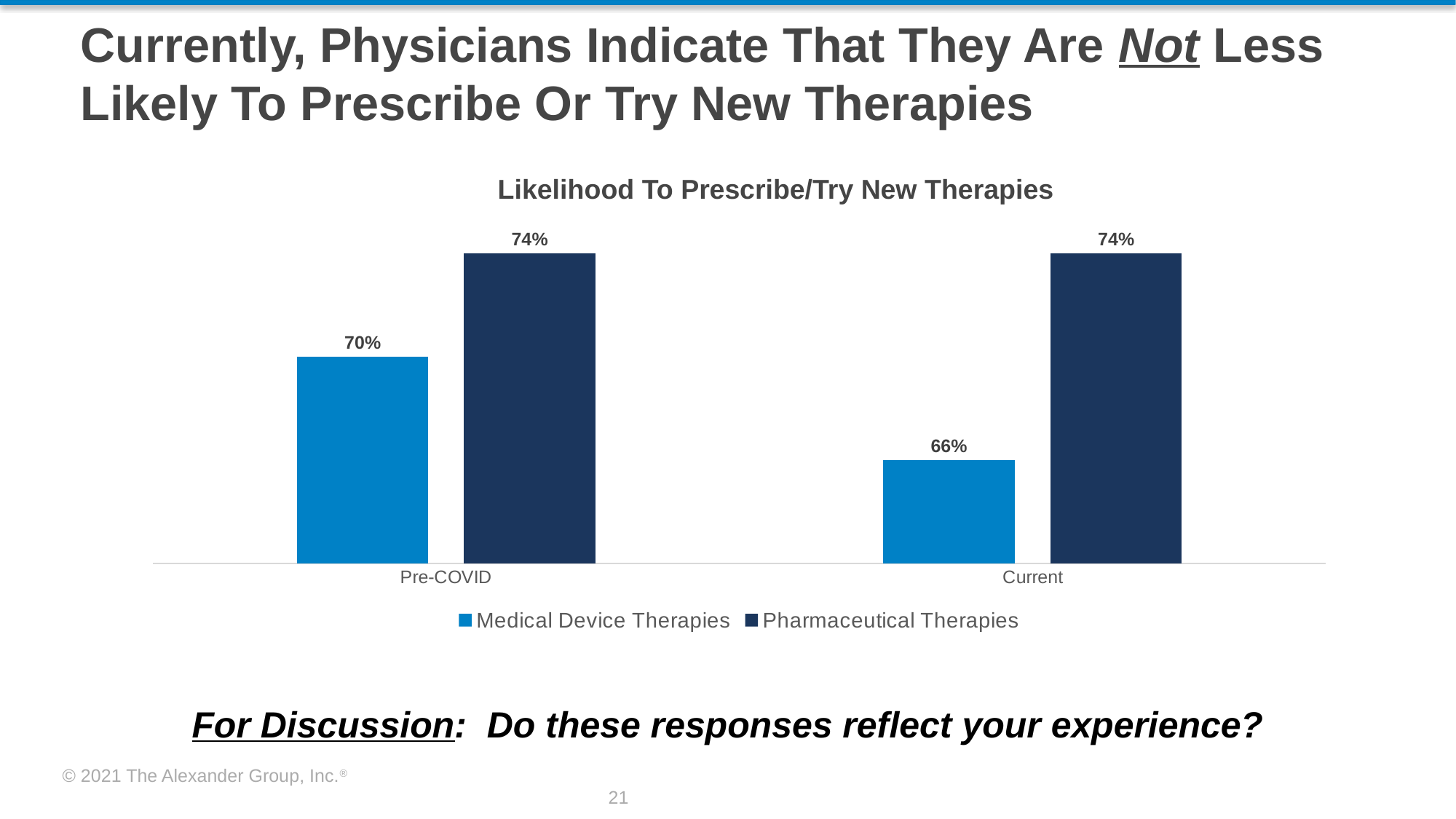
What is the value for Pharmaceutical Therapies in the Pre-COVID category? 74% Which is larger: Medical Device Therapies Pre-COVID or Medical Device Therapies Current? Medical Device Therapies Pre-COVID What is the value for Medical Device Therapies in the Current category? 66% What is the title of the chart? Likelihood To Prescribe/Try New Therapies What is the value for Pharmaceutical Therapies in the Current category? 74% What is the value for Medical Device Therapies in the Pre-COVID category? 70% What is the difference between Pharmaceutical Therapies and Medical Device Therapies in the Current category? 8% How many categories are shown on the x axis? 2 What kind of chart is shown on the slide? Bar chart How many series does the legend list? 2 What is the difference between the Pre-COVID and Current values for Medical Device Therapies? 4% Which series has the lowest value in the Current category? Medical Device Therapies